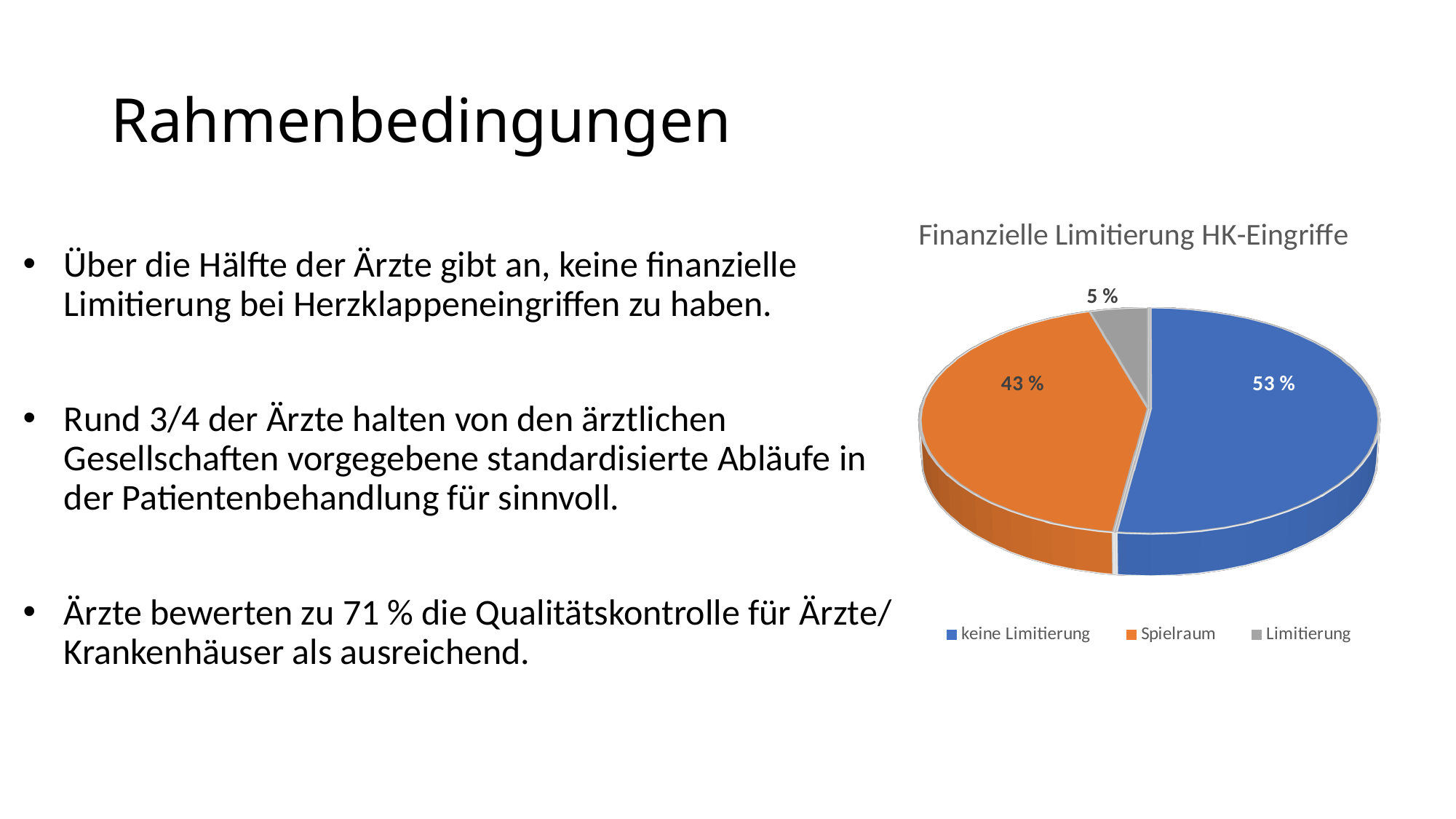
What is the title of the chart? Finanzielle Limitierung HK-Eingriffe Which is larger, the slice for 'Spielraum' or the slice for 'Limitierung'? Spielraum How many categories does the pie chart show? 3 Which colour represents 'Spielraum' in the chart? orange Which category has the largest slice of the pie? keine Limitierung What share of the pie does 'Limitierung' have? 5 % What is the difference in percentage points between 'Spielraum' and 'Limitierung'? 38 What share of the pie does 'Spielraum' have? 43 % What is the difference in percentage points between 'keine Limitierung' and 'Spielraum'? 10 What share of the pie does 'keine Limitierung' have? 53 % Which category has the smallest slice of the pie? Limitierung What kind of chart is shown on the slide? pie chart